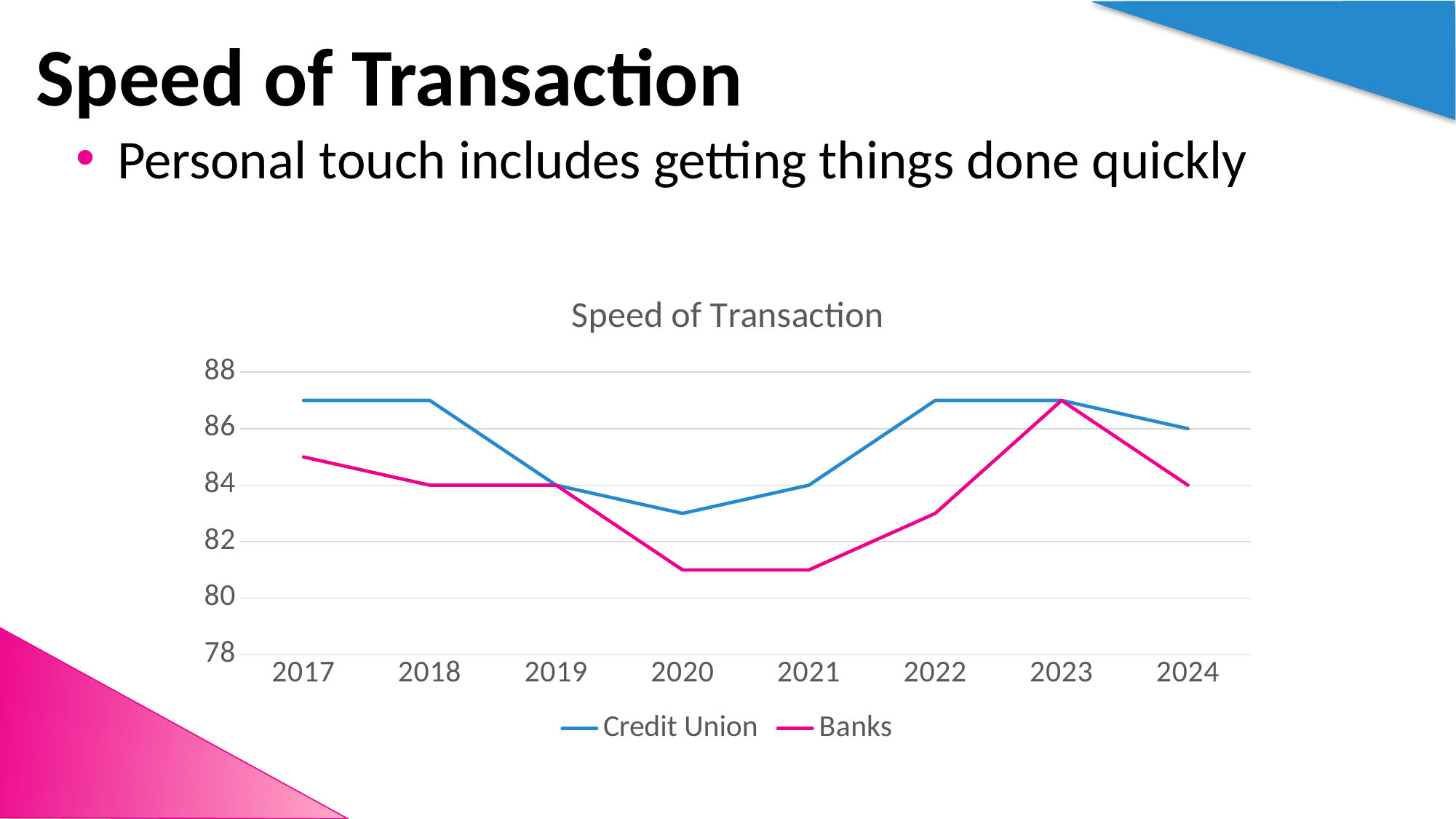
Is the value for Banks in 2020 greater or less than 82? less What is the value for Credit Union in 2024? 86 Is the value for Credit Union in 2017 greater or less than 86? greater Does the Banks series rise or fall from 2023 to 2024? fall How many series does the legend list? 2 What is the value for Banks in 2024? 84 What is the value for Credit Union in 2019? 84 Which series has the higher value in 2021, Credit Union or Banks? Credit Union In which year does the Banks series reach its lowest value? 2020 and 2021 How many years are shown on the x axis? 8 What is the title of the chart? Speed of Transaction What kind of chart is shown on the slide? line chart